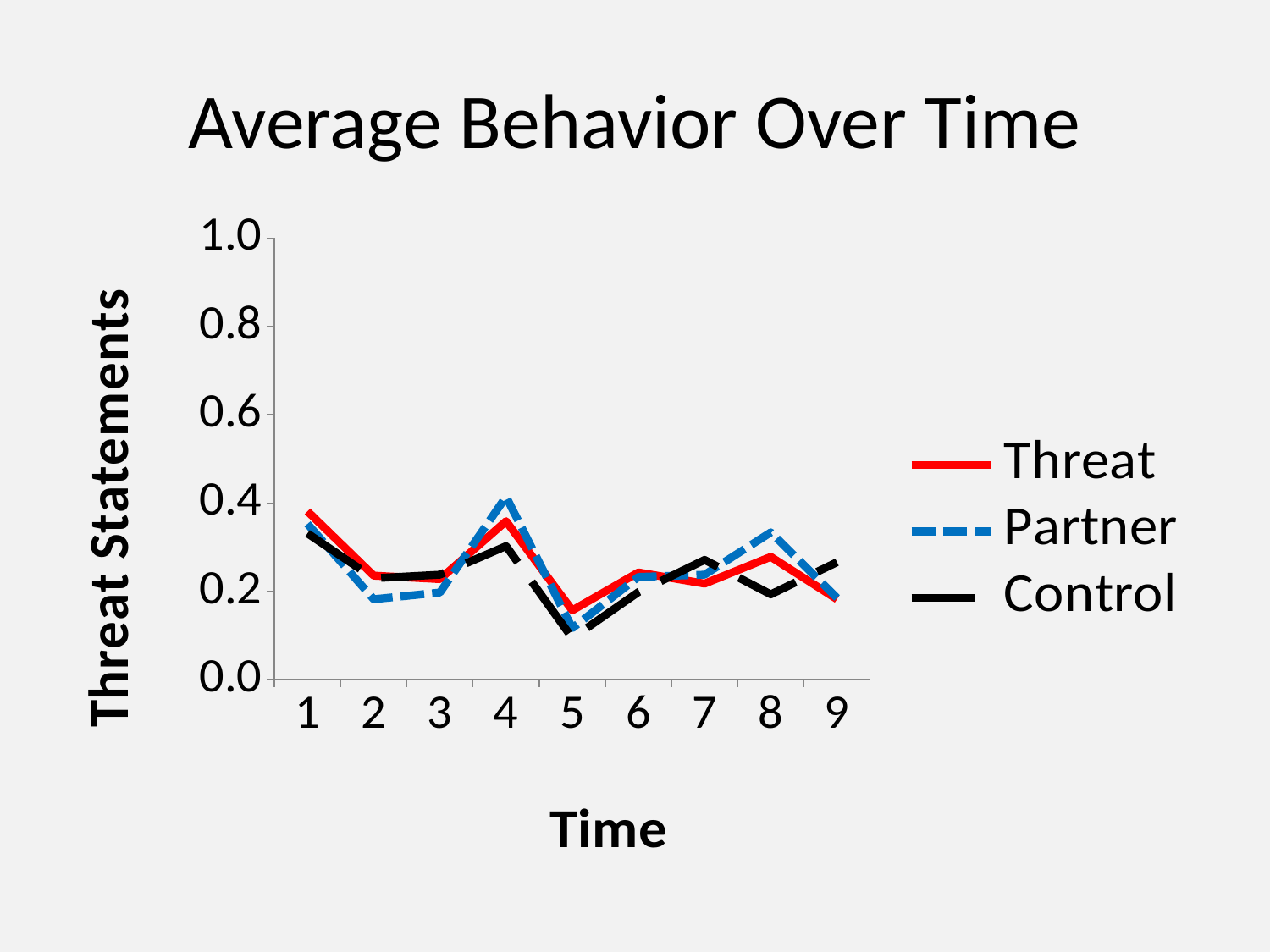
At time 8, which series has the larger value, Partner or Control? Partner Do the values for all three series rise or fall from time 4 to time 5? fall At time 2, which series has the larger value, Threat or Partner? Threat At which time point does the Control series reach its lowest value? 5 Which series reaches the highest value at time 4? Partner Is the value for Partner at time 4 greater or less than 0.2? greater How many time points are plotted along the x axis? 9 Is the value for Threat at time 1 greater or less than 0.6? less What is the label on the y axis? Threat Statements How many series does the legend list? 3 What kind of chart is shown on the slide? line chart Is the value for Control at time 5 greater or less than 0.2? less